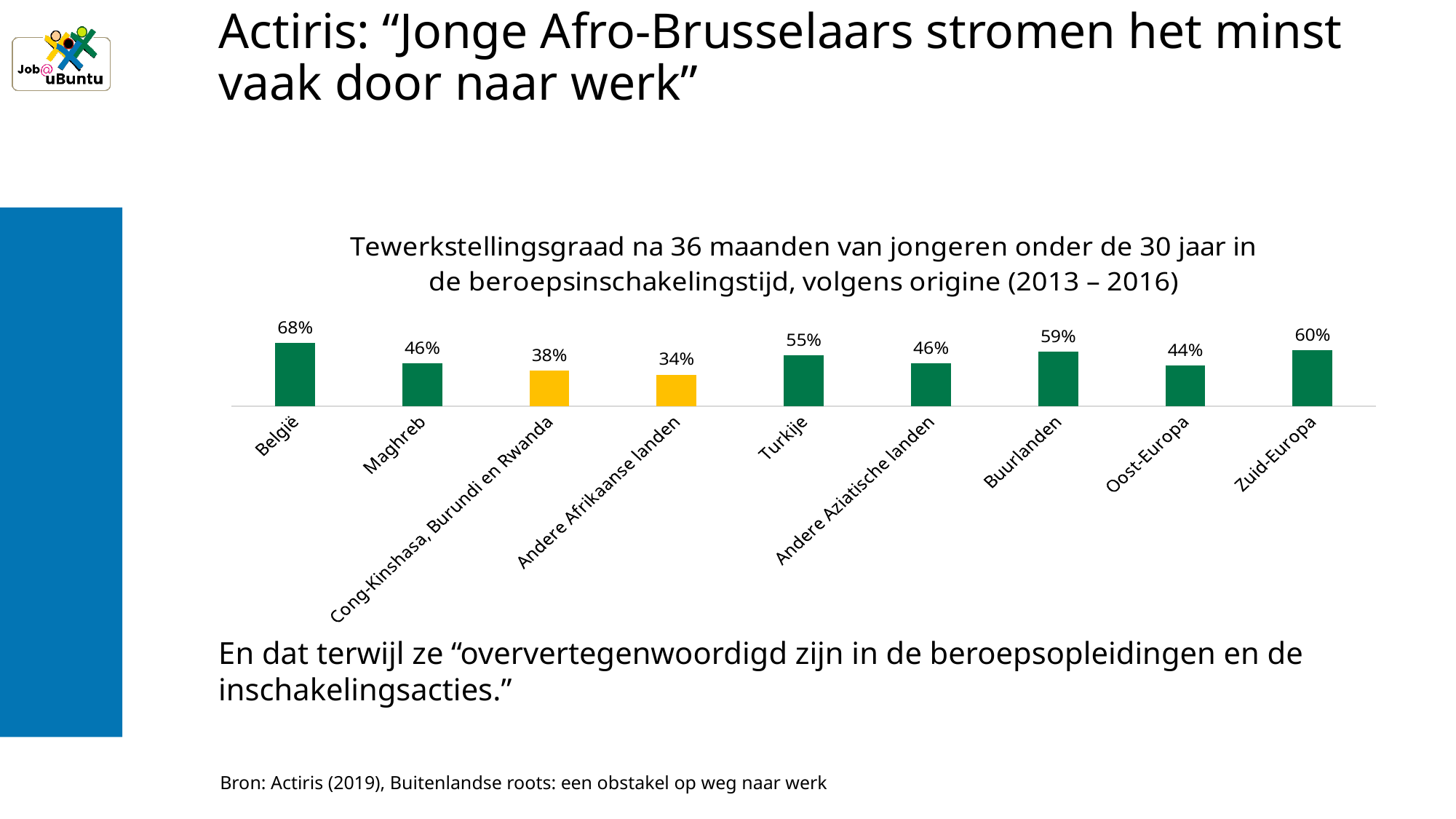
Which category has the highest value? België What is the value for Andere Afrikaanse landen? 34% What is the difference between the values for Zuid-Europa and Maghreb? 14% What is the value for Cong-Kinshasa, Burundi en Rwanda? 38% What is the value for Buurlanden? 59% How many categories are shown in the chart? 9 Which two categories are shown with yellow bars instead of green? Cong-Kinshasa, Burundi en Rwanda and Andere Afrikaanse landen Which is larger, the value for Turkije or the value for Oost-Europa? Turkije Which category has the lowest value? Andere Afrikaanse landen What is the difference between the values for België and Andere Afrikaanse landen? 34% What is the value for België? 68% What kind of chart is shown on the slide? Bar chart